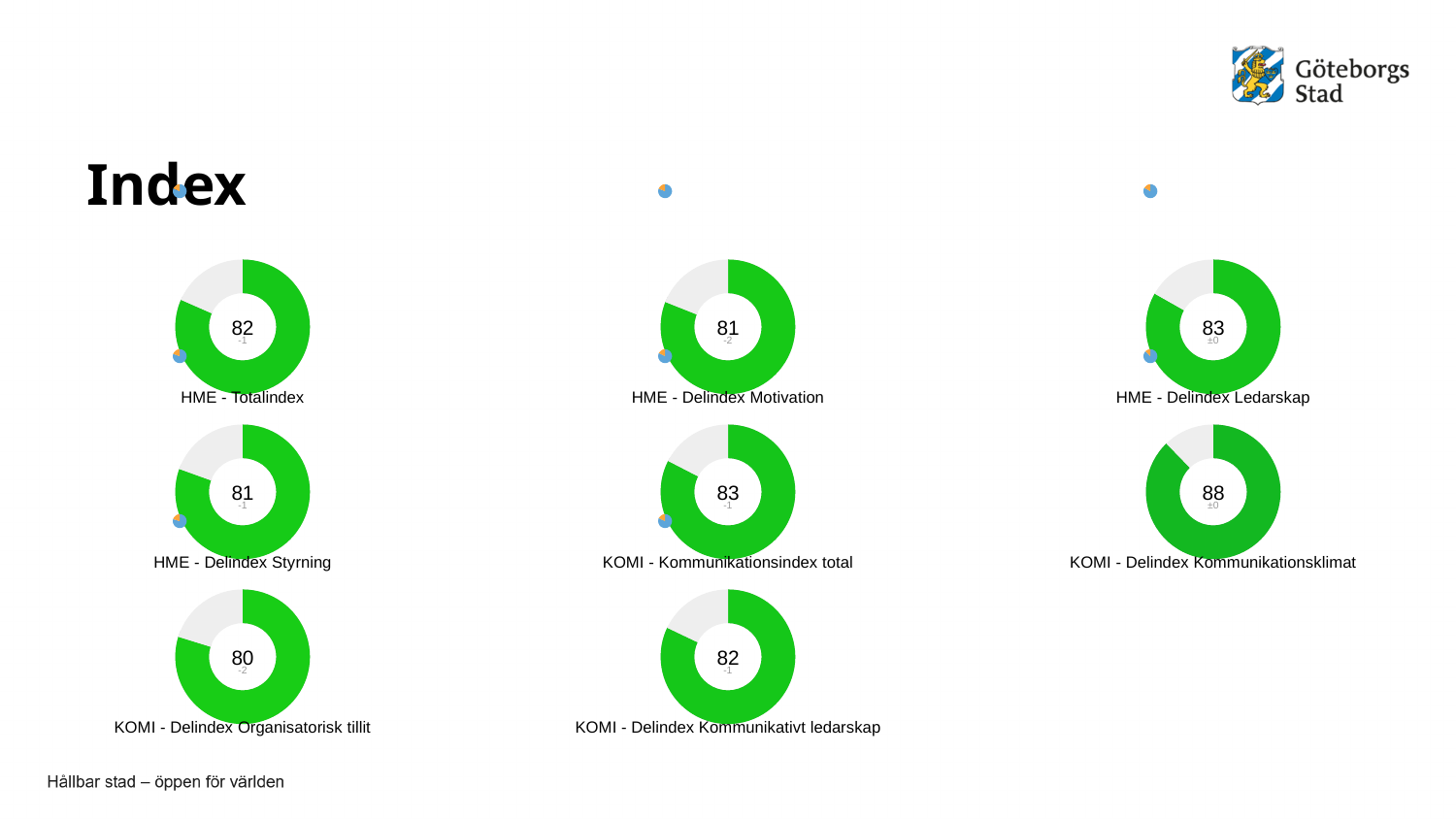
Which chart on the slide shows the highest index value? KOMI - Delindex Kommunikationsklimat What value is shown in the centre of the HME - Totalindex chart? 82 How many donut charts are shown on the slide? 8 What change value is printed under the main number in the HME - Delindex Ledarskap chart? ±0 Which chart on the slide shows the lowest index value? KOMI - Delindex Organisatorisk tillit What type of chart is used for HME - Totalindex? Donut chart What change value is printed under the main number in the KOMI - Delindex Organisatorisk tillit chart? -2 What is the difference between the KOMI - Delindex Kommunikationsklimat value and the KOMI - Delindex Organisatorisk tillit value? 8 What value is shown in the centre of the HME - Delindex Motivation chart? 81 What value is shown in the centre of the KOMI - Delindex Organisatorisk tillit chart? 80 What value is shown in the centre of the KOMI - Delindex Kommunikationsklimat chart? 88 Which is larger, the HME - Delindex Ledarskap value or the HME - Delindex Styrning value? HME - Delindex Ledarskap